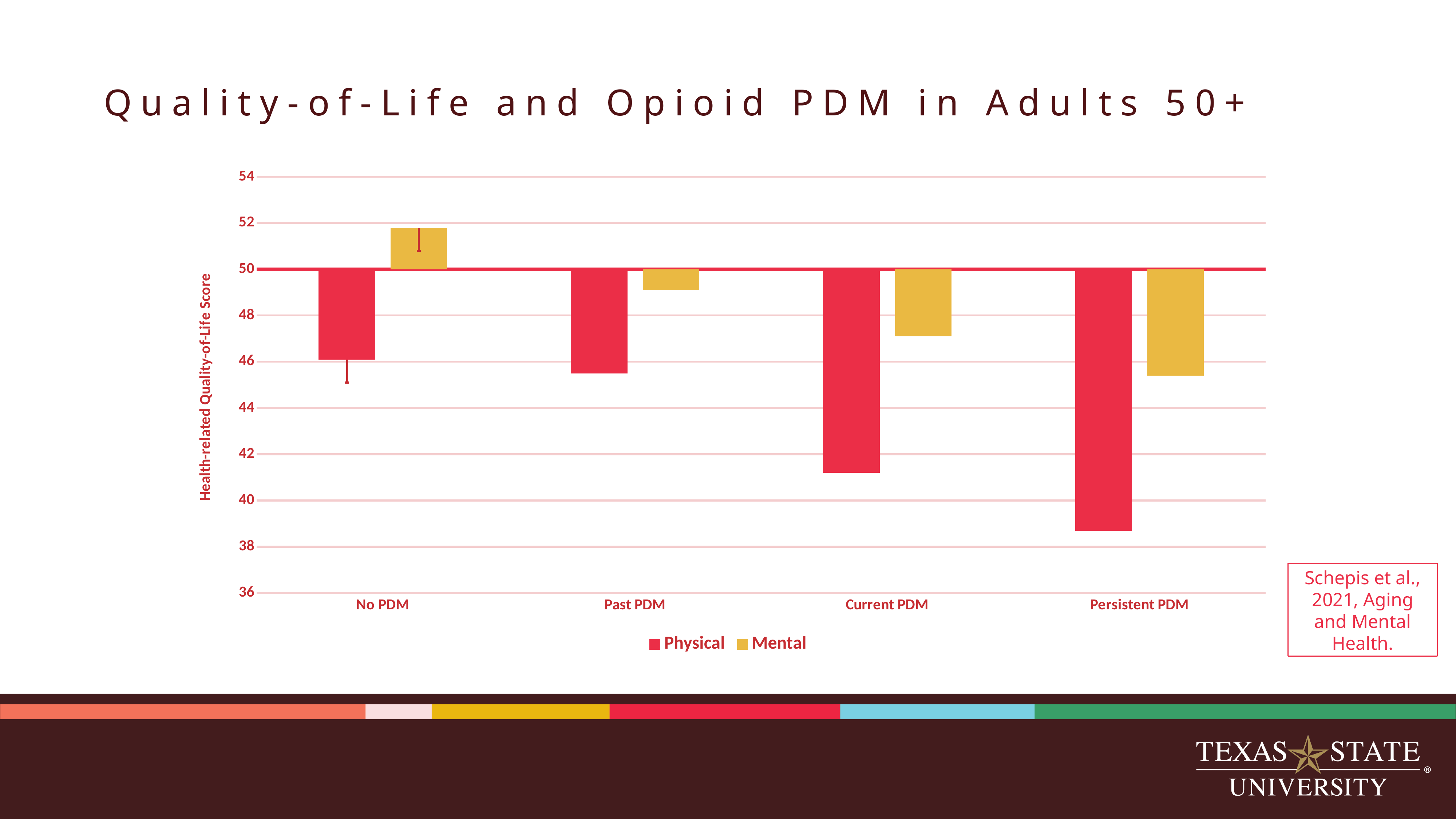
Which category has the lowest Physical score? Persistent PDM Which category has the highest Mental score? No PDM How many series does the legend list? 2 What kind of chart is shown on the slide? bar chart Is the Physical score for Persistent PDM greater or less than 40? less For Current PDM, which is larger, the Physical score or the Mental score? Mental How many categories are shown on the x axis? 4 Is the Physical score for Current PDM greater or less than 42? less What is the label on the vertical axis? Health-related Quality-of-Life Score Which category has the lowest Mental score? Persistent PDM Do the Physical scores rise or fall moving from No PDM to Persistent PDM? fall Is the Mental score for No PDM greater or less than 50? greater